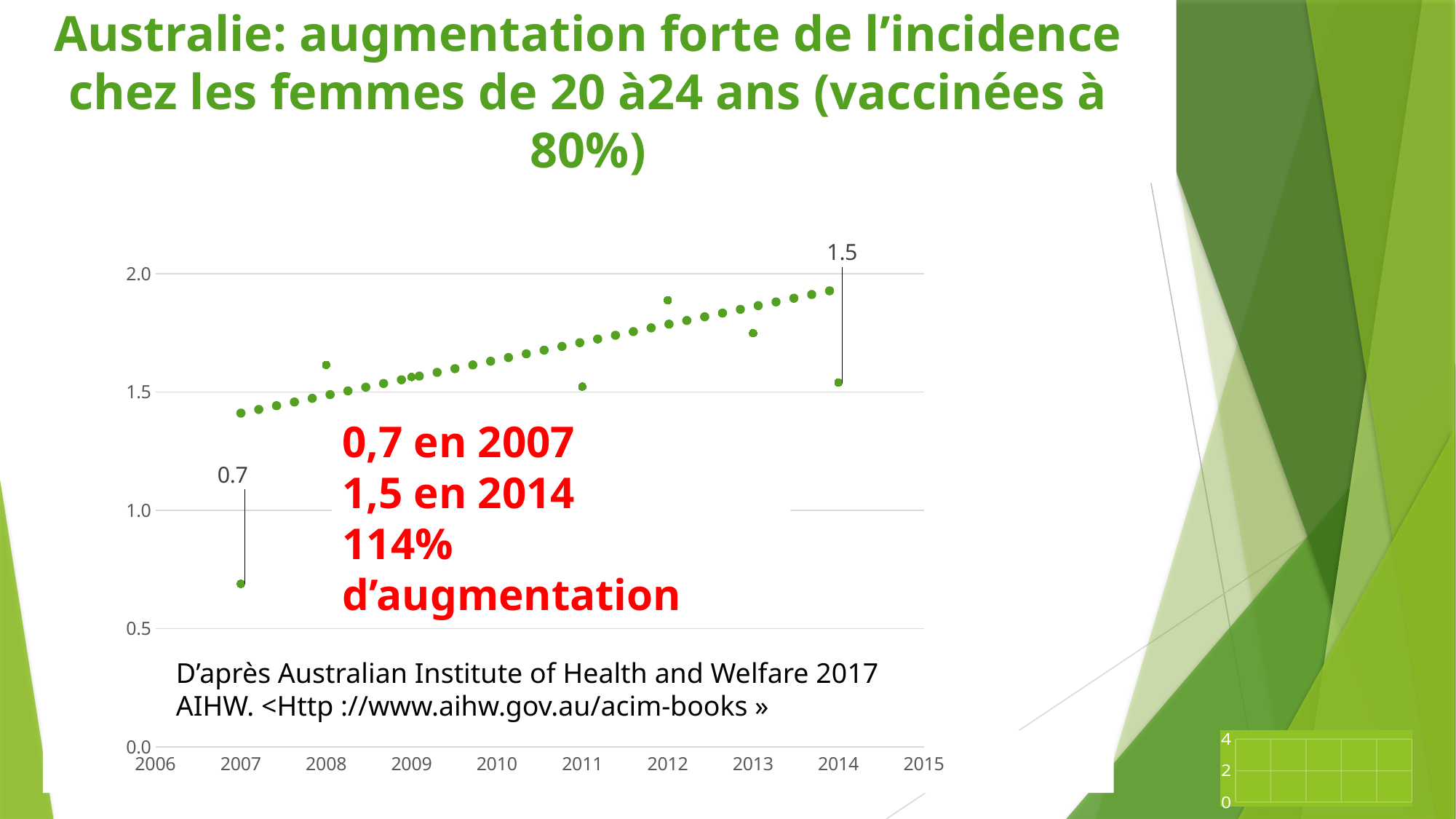
What kind of chart is shown on the slide? scatter chart What is the value for 2007? 0.7 Which year has the lowest value? 2007 What is the difference between the value for 2014 and the value for 2007? 0.8 What percentage increase is stated in the red text on the chart? 114% Is the value for 2012 greater or less than 1.5? greater Is the value for 2013 greater or less than 1.5? greater Which is larger, the value for 2007 or the value for 2014? 2014 What is the value for 2014? 1.5 Is the value for 2007 greater or less than 1.0? less Do the values generally rise or fall from 2007 to 2014? rise